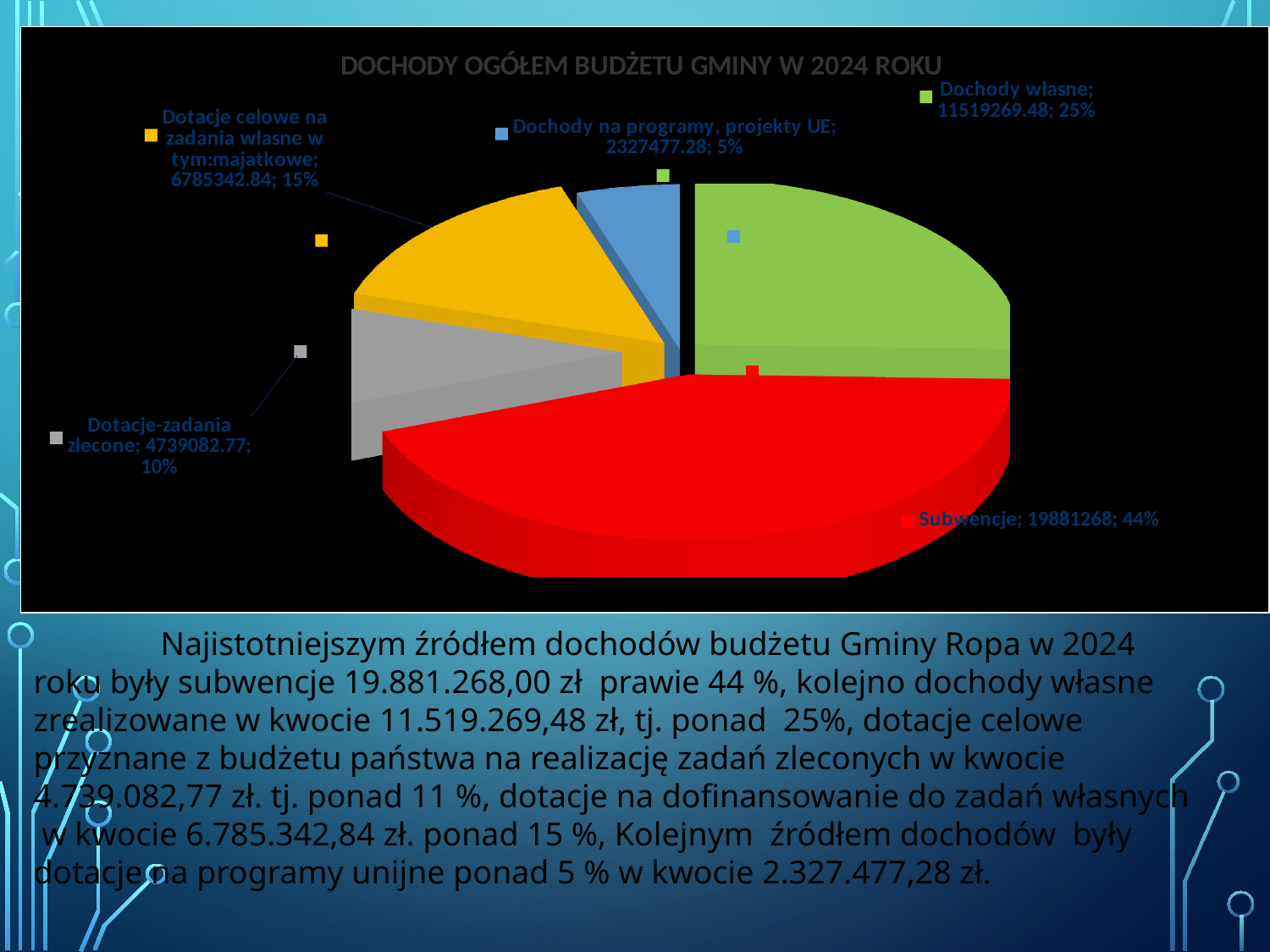
How many slices does the pie chart have? 5 What is the value shown for Dochody na programy, projekty UE? 2327477.28 Which is larger, Dochody własne or Dotacje-zadania zlecone? Dochody własne Which category has the smallest slice of the pie? Dochody na programy, projekty UE What share of the pie does Subwencje represent? 44% What is the value shown for Dotacje-zadania zlecone? 4739082.77 What is the title of the chart? DOCHODY OGÓŁEM BUDŻETU GMINY W 2024 ROKU What is the value shown for Dochody własne? 11519269.48 Which category has the largest slice of the pie? Subwencje What is the value shown for Subwencje? 19881268 What kind of chart is shown on the slide? pie chart What share of the pie does Dotacje celowe na zadania własne w tym:majatkowe represent? 15%